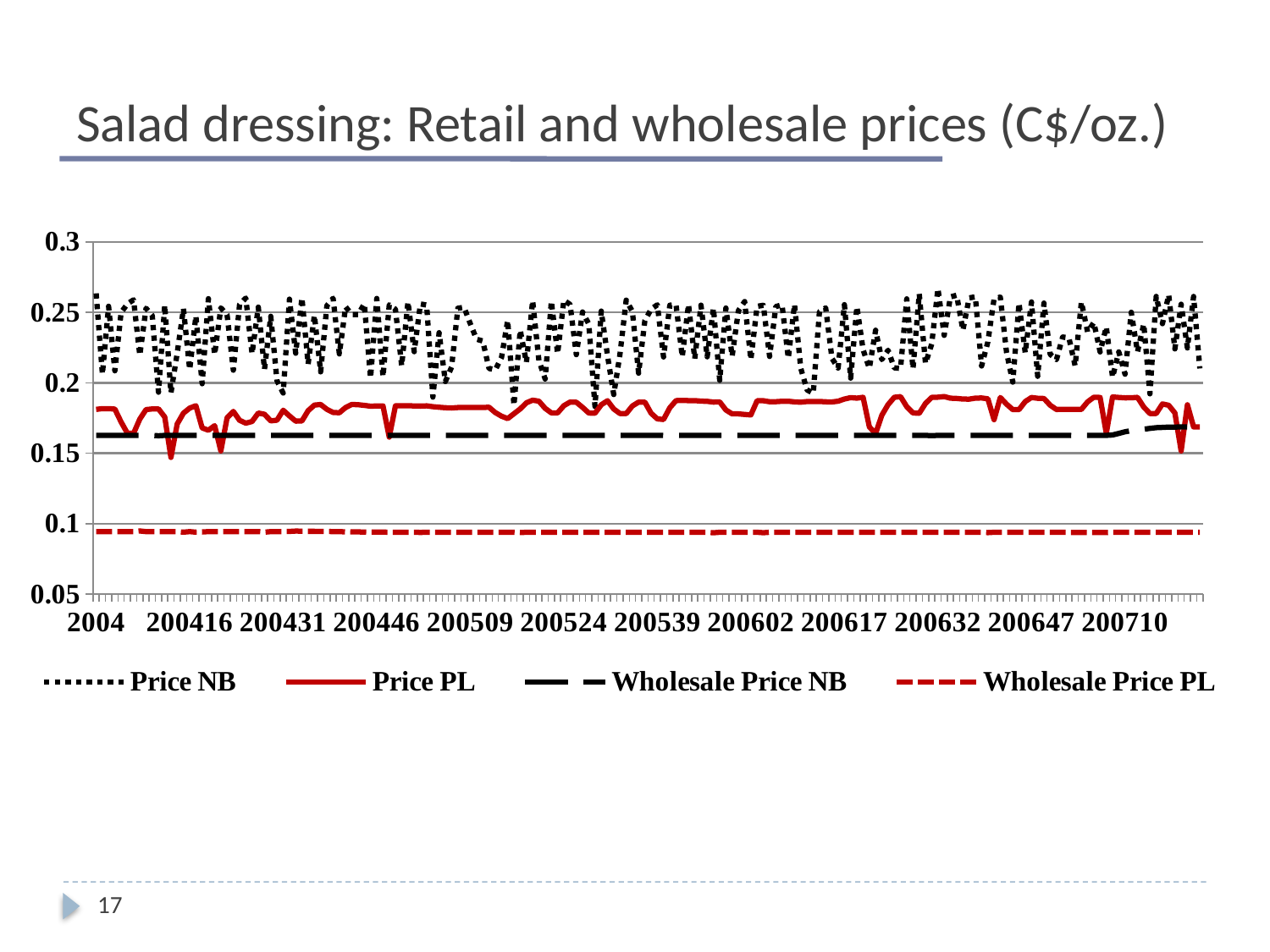
Is the value for Wholesale Price PL greater or less than 0.1? less Which series has the highest values across the chart? Price NB Which series has the lowest values across the chart? Wholesale Price PL Is the value for Price PL greater or less than 0.2 throughout the period? less Which series is drawn as a solid red line? Price PL Which is larger, Wholesale Price NB or Wholesale Price PL? Wholesale Price NB What is the first label shown on the x axis? 2004 Which is larger, Price NB or Price PL? Price NB Is the value for Wholesale Price NB greater or less than 0.15? greater How many series does the legend list? 4 What is the title of the chart? Salad dressing: Retail and wholesale prices (C$/oz.) What kind of chart is shown on the slide? line chart